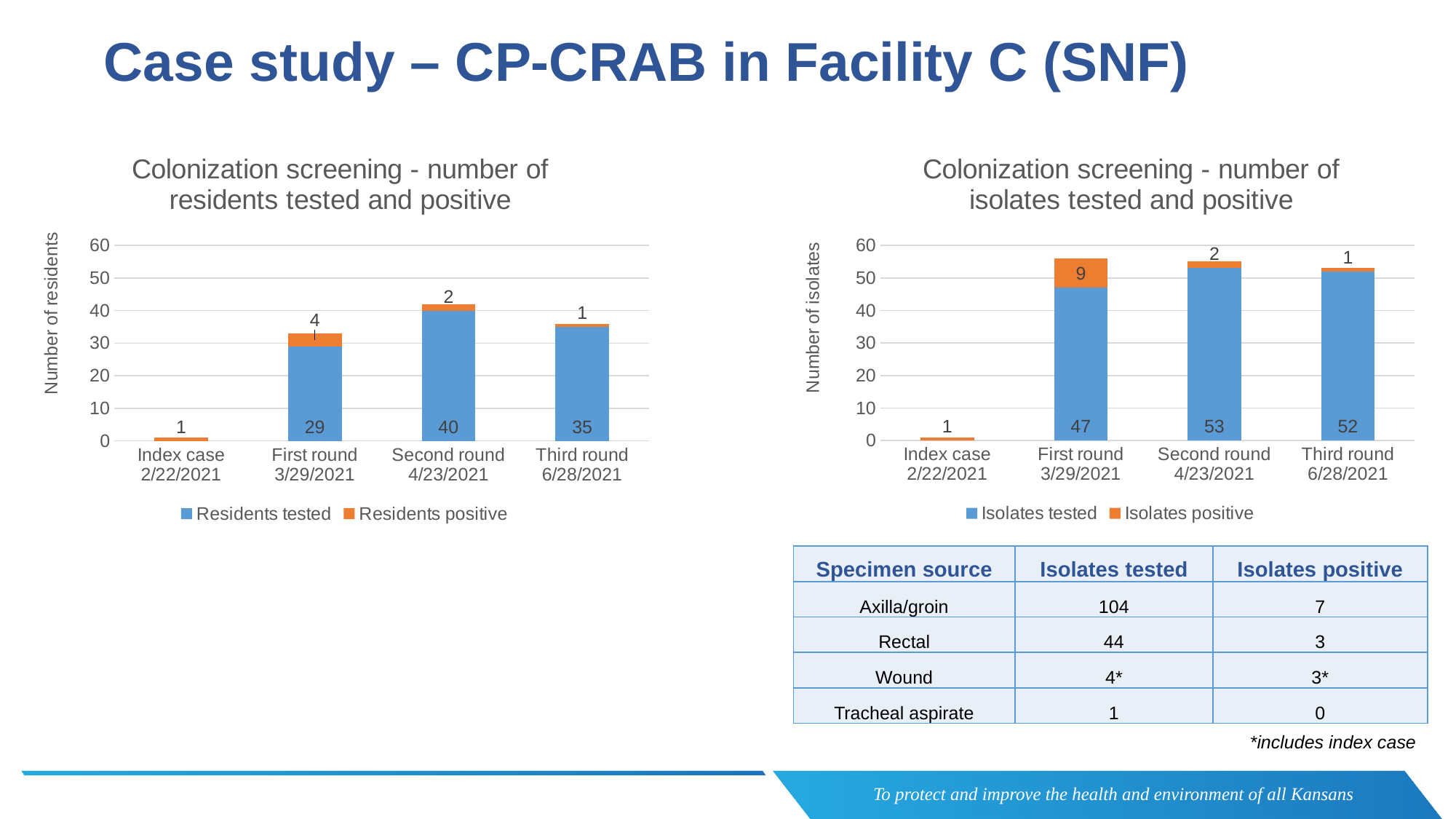
In the chart 'Colonization screening - number of residents tested and positive', which round had the highest number of residents tested? Second round 4/23/2021 In the chart 'Colonization screening - number of isolates tested and positive', what is the difference between isolates tested in the second round and the first round? 6 In the chart 'Colonization screening - number of residents tested and positive', how many residents were tested in the second round (4/23/2021)? 40 In the chart 'Colonization screening - number of isolates tested and positive', which round had the most isolates positive? First round 3/29/2021 In the chart 'Colonization screening - number of residents tested and positive', how many series does the legend list? 2 What type of chart is 'Colonization screening - number of isolates tested and positive'? Stacked bar chart In the chart 'Colonization screening - number of residents tested and positive', what is the total height of the stacked bar for the first round (3/29/2021)? 33 In the chart 'Colonization screening - number of isolates tested and positive', how many isolates were positive in the first round (3/29/2021)? 9 In the chart 'Colonization screening - number of residents tested and positive', how many residents were positive in the first round (3/29/2021)? 4 How many categories are shown on the x axis of the chart 'Colonization screening - number of residents tested and positive'? 4 In the chart 'Colonization screening - number of isolates tested and positive', how many isolates were tested in the third round (6/28/2021)? 52 In the chart 'Colonization screening - number of isolates tested and positive', what is the total height of the stacked bar for the second round (4/23/2021)? 55